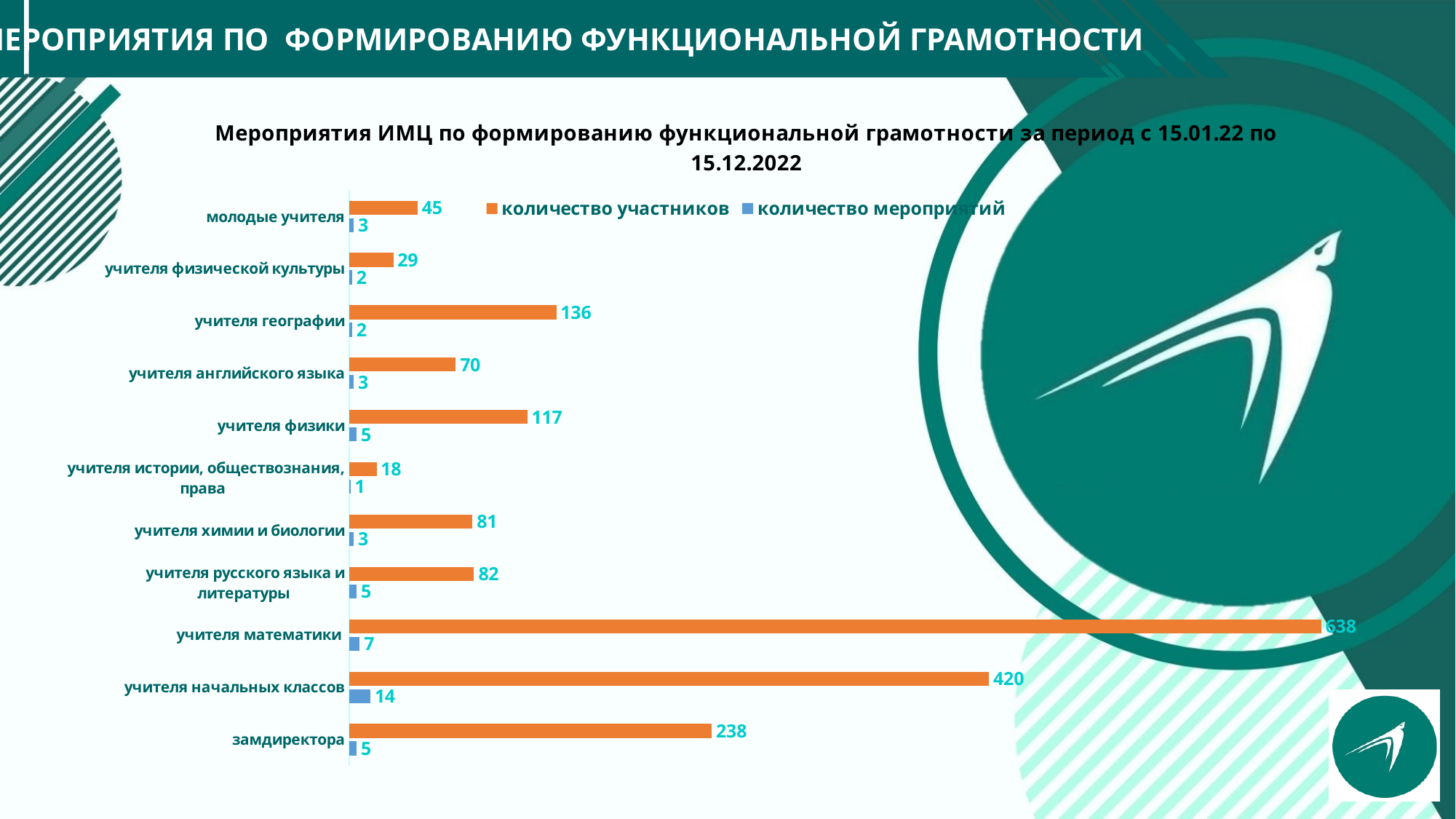
What is the value of "количество участников" for "учителя математики"? 638 What kind of chart is shown on the slide? bar chart Which category has the highest value for "количество участников"? учителя математики Which series is shown in orange in the legend? количество участников Which category has the lowest value for "количество мероприятий"? учителя истории, обществознания, права What is the value of "количество мероприятий" for "учителя начальных классов"? 14 How many series does the legend list? 2 Which has a larger value for "количество участников": "учителя географии" or "учителя физики"? учителя географии What is the difference in "количество участников" between "учителя математики" and "учителя начальных классов"? 218 What is the value of "количество участников" for "замдиректора"? 238 What is the value of "количество мероприятий" for "учителя физики"? 5 How many categories are shown on the chart? 11